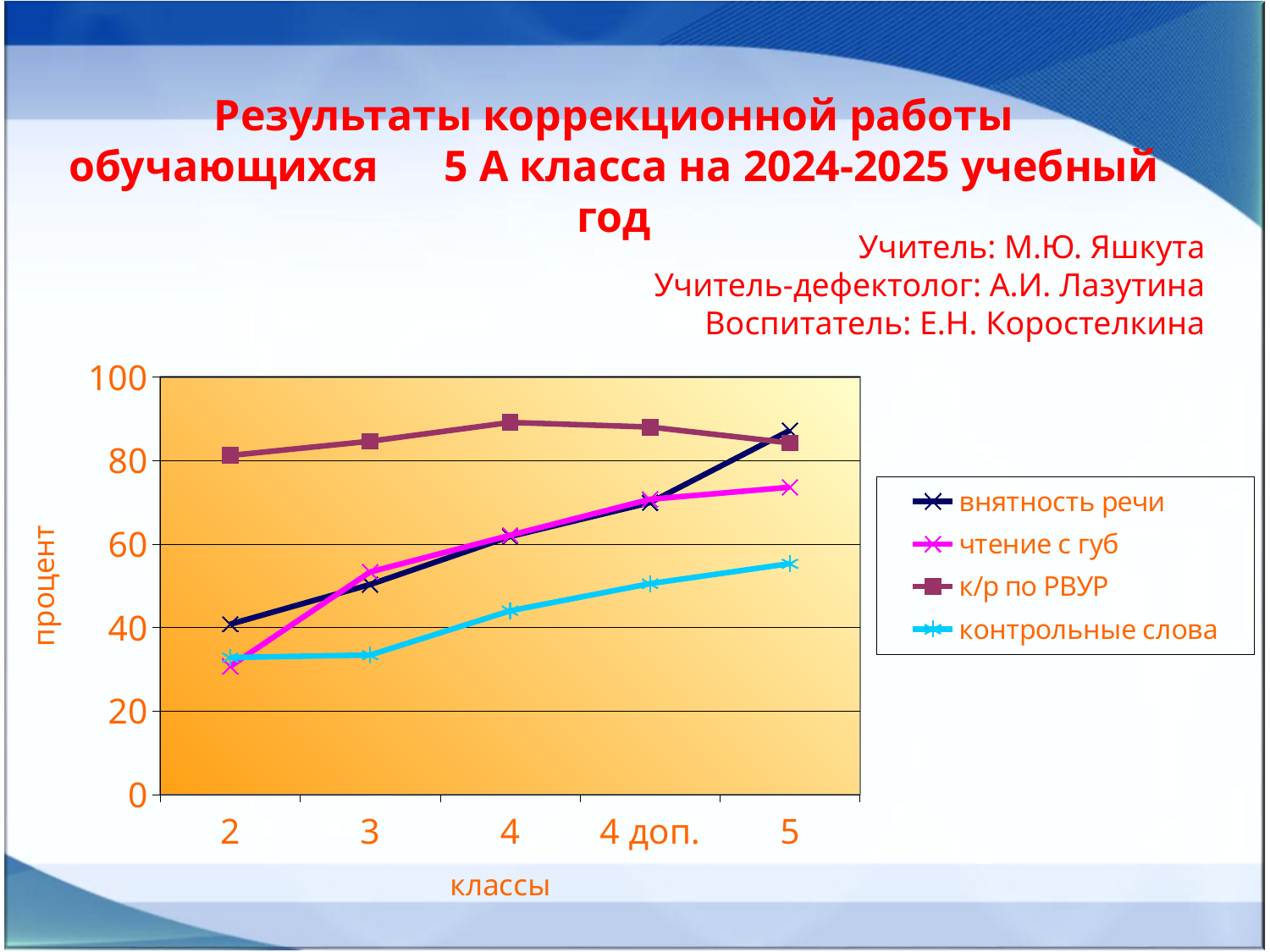
At class 5, which is larger: 'внятность речи' or 'чтение с губ'? внятность речи Which series has the highest value at class 2? к/р по РВУР Is the value for 'внятность речи' at class 2 greater or less than 60? less How many series does the legend list? 4 Is the value for 'к/р по РВУР' at class 4 greater or less than 80? greater At class 2, which is larger: 'к/р по РВУР' or 'внятность речи'? к/р по РВУР What kind of chart is shown on the slide? line chart Is the value for 'чтение с губ' at class 5 greater or less than 80? less Which series has the lowest value at class 5? контрольные слова Does the series 'контрольные слова' rise or fall from class 2 to class 5? rise How many categories are shown on the x axis? 5